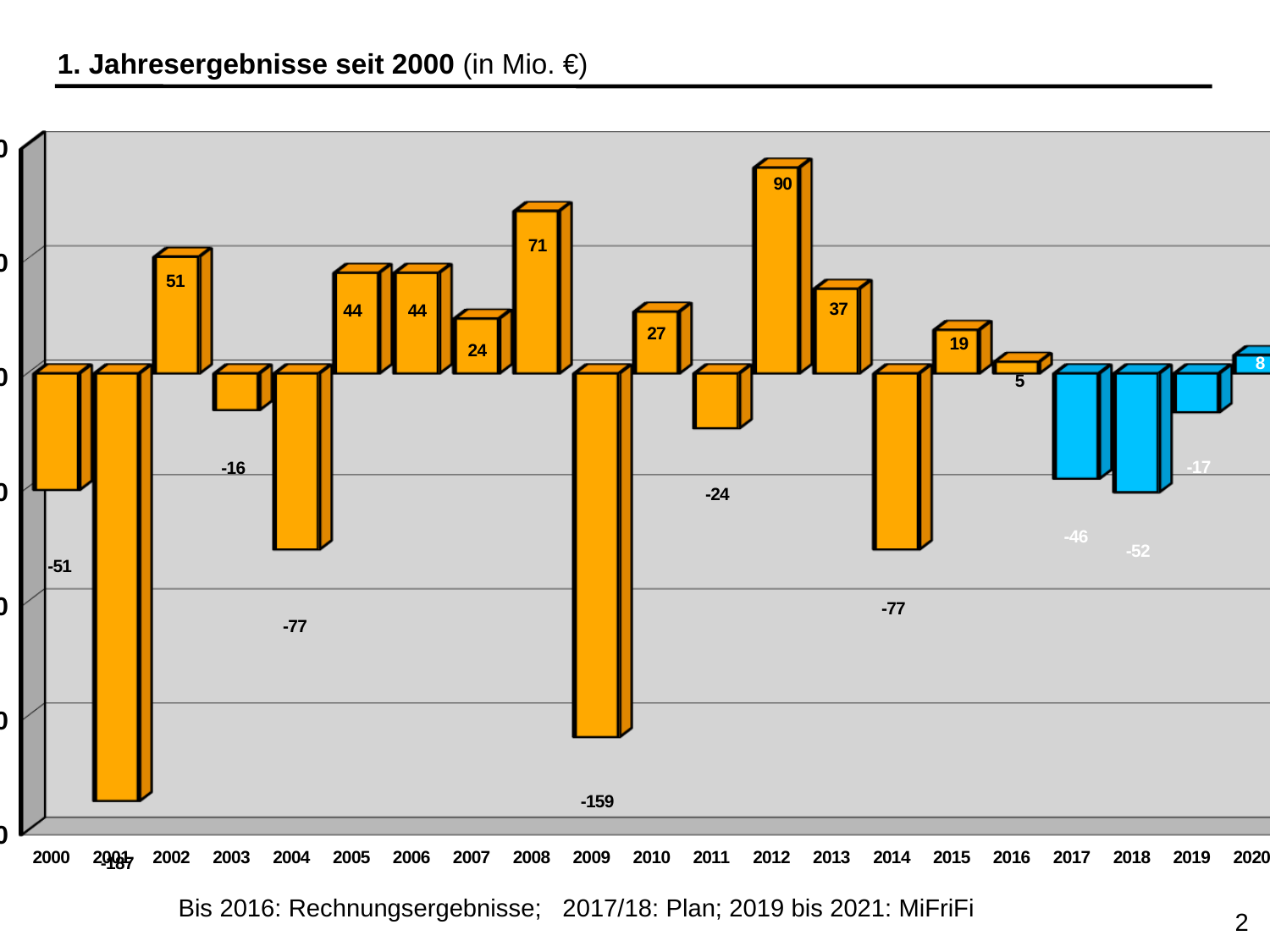
What kind of chart is shown on the slide? bar chart What is the value for 2009? -159 What is the difference between the values for 2002 and 2013? 14 What is the value for 2018? -52 Which is larger, the value for 2017 or the value for 2019? 2019 What colour are the bars for 2017 to 2020? blue Which year has the lowest value? 2001 What is the value for 2012? 90 What is the difference between the values for 2012 and 2008? 19 Which year has the highest value? 2012 Which is larger, the value for 2005 or the value for 2007? 2005 What is the value for 2016? 5